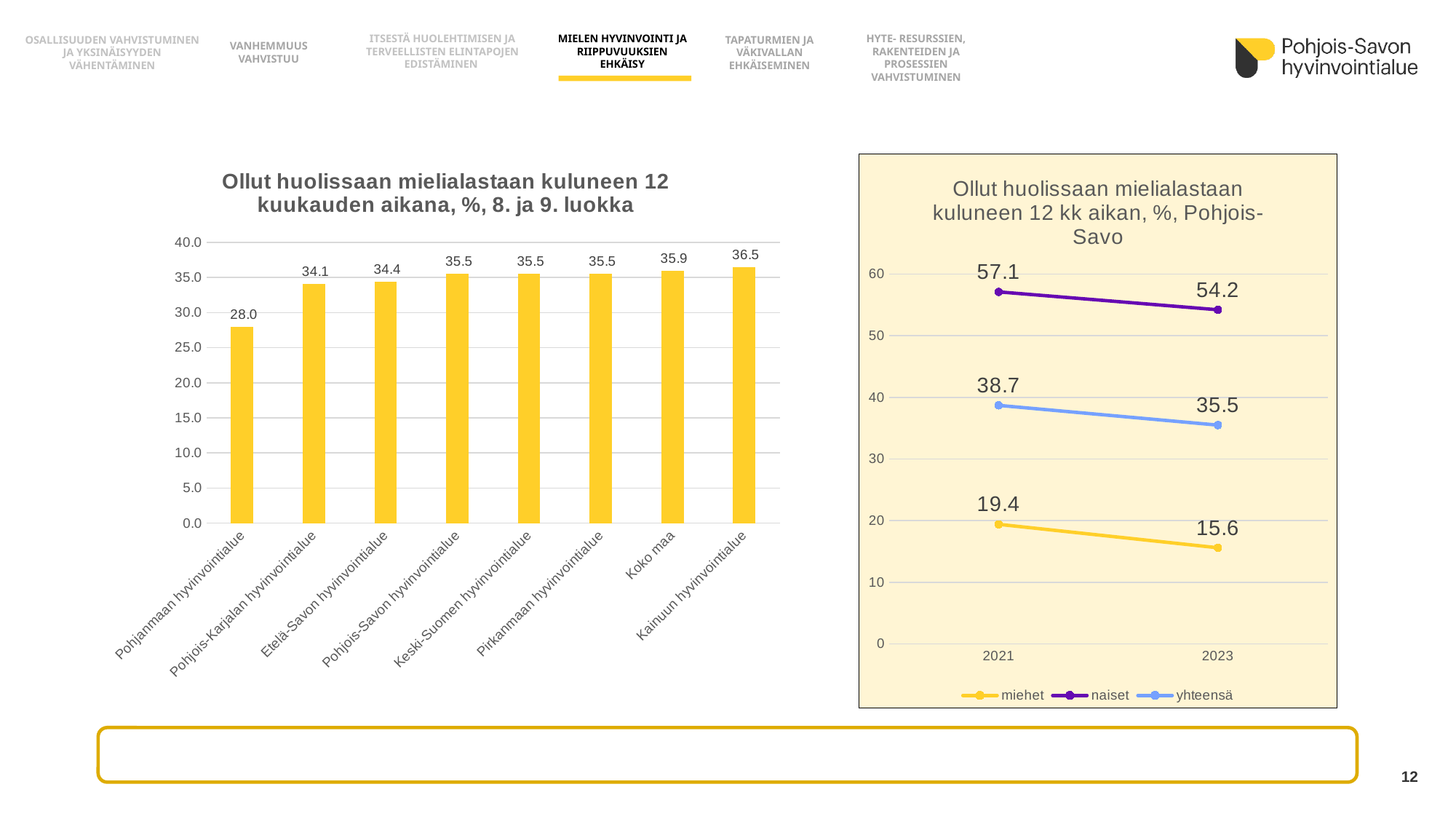
In the left bar chart, what is the value for Koko maa? 35.9 In the right line chart, what is the difference between naiset and miehet in 2021? 37.7 In the right line chart, does the yhteensä series rise or fall from 2021 to 2023? fall In the right line chart, what is the value for miehet in 2021? 19.4 In the left bar chart, which category has the lowest value? Pohjanmaan hyvinvointialue In the left bar chart, how many categories are shown? 8 In the left bar chart, what is the value for Pohjanmaan hyvinvointialue? 28.0 In the left bar chart, which category has the highest value? Kainuun hyvinvointialue What kind of chart is the chart on the left? bar chart In the right line chart, what is the value for naiset in 2023? 54.2 In the left bar chart, what is the difference between Kainuun hyvinvointialue and Pohjanmaan hyvinvointialue? 8.5 In the right line chart, how many series does the legend list? 3